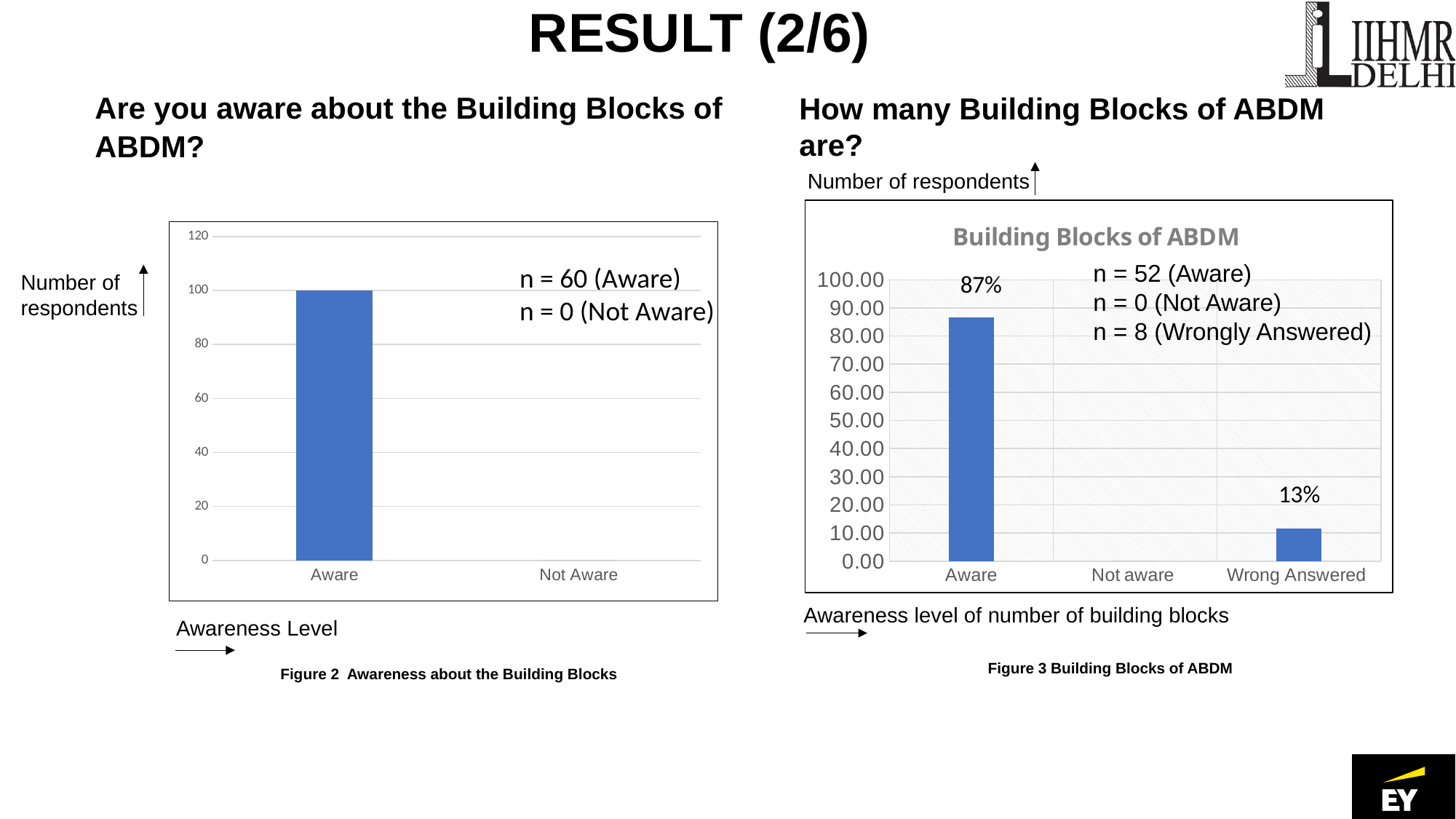
In the left chart (Figure 2), how many categories are shown on the x axis? 2 In the chart titled 'Building Blocks of ABDM', is the value for Wrong Answered greater or less than 20.00? less In the left chart (Figure 2), what is the value for Aware? 100 What kind of chart is the left chart (Figure 2)? bar chart What is the title of the chart on the right side of the slide? Building Blocks of ABDM In the chart titled 'Building Blocks of ABDM', what is the difference between the values for Aware and Wrong Answered? 74% In the chart titled 'Building Blocks of ABDM', which category has the highest value? Aware In the chart titled 'Building Blocks of ABDM', what is the value for Wrong Answered? 13% In the chart titled 'Building Blocks of ABDM', how many categories are shown on the x axis? 3 In the left chart (Figure 2), is the value for Aware greater or less than 80? greater In the left chart (Figure 2), which category has the highest value? Aware In the chart titled 'Building Blocks of ABDM', what is the value for Aware? 87%